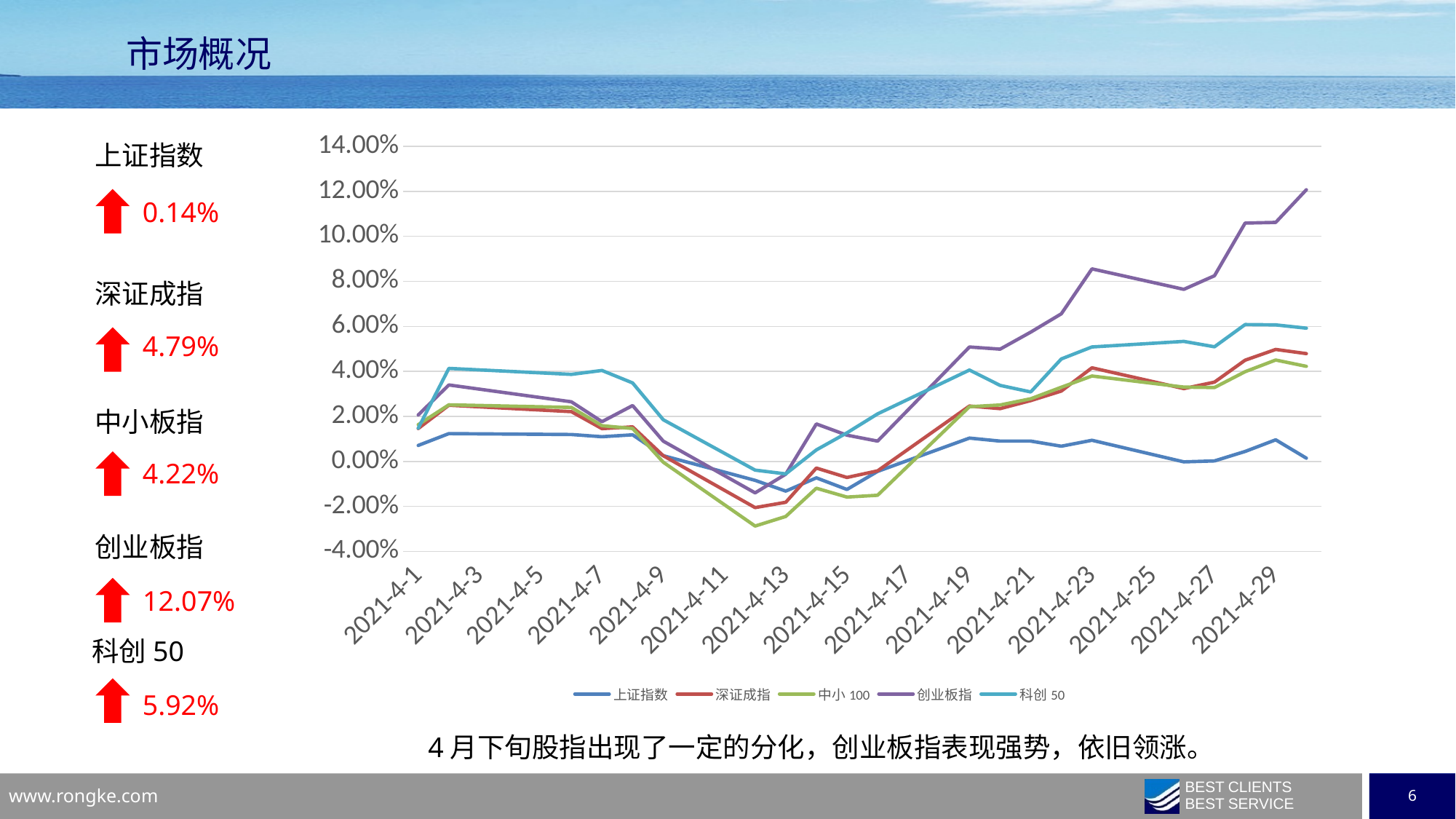
Which series has the lowest value at the last date on the chart? 上证指数 How many series does the chart legend list? 5 At 2021-4-13, which is higher: 上证指数 or 中小 100? 上证指数 Which series has the highest value at the last date on the chart? 创业板指 What is the difference between the change shown for 创业板指 (12.07%) and for 上证指数 (0.14%)? 11.93% What kind of chart is shown on the slide? line chart Is the value for 创业板指 at the last date greater or less than 10.00%? greater Is the value for 上证指数 at 2021-4-13 greater or less than 0.00%? less What change is shown on the slide for 创业板指? 12.07% How many date labels are shown on the x axis? 15 Is the value for 中小 100 at 2021-4-13 greater or less than -2.00%? less Does the 创业板指 line rise or fall from 2021-4-13 to the end of the chart? rise